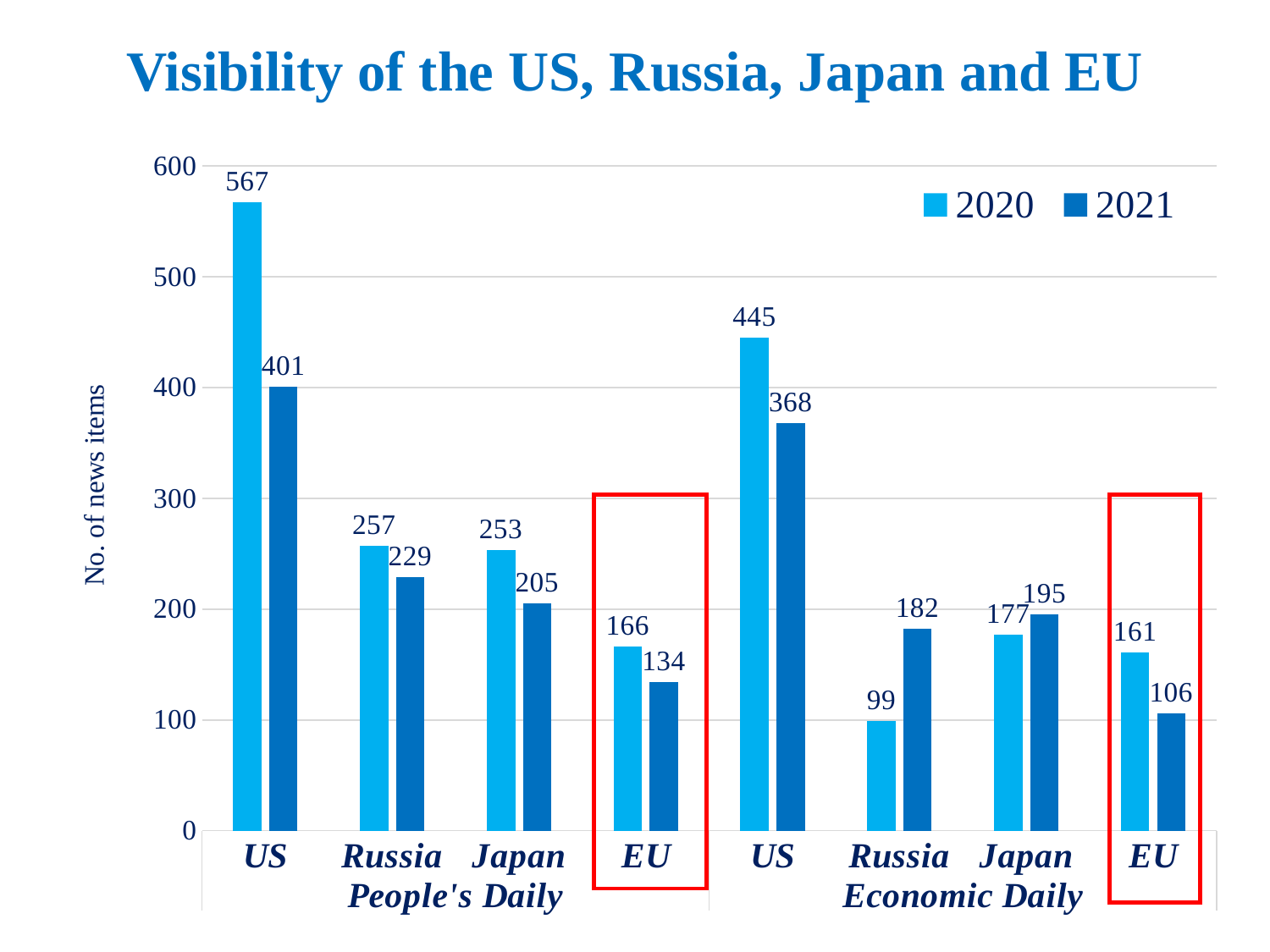
Which category has the lowest 2020 value across both newspapers? Russia (Economic Daily) What is the difference between the 2020 and 2021 values for the US in Economic Daily? 77 What kind of chart is shown on the slide? bar chart What is the label on the vertical axis? No. of news items Is the 2021 value for the US in People's Daily greater or less than 400? greater How many series does the legend list? 2 What is the 2021 value for Russia in Economic Daily? 182 Which category has the highest 2020 value across both newspapers? US (People's Daily) What is the 2020 value for the US in People's Daily? 567 What is the title of the chart? Visibility of the US, Russia, Japan and EU Which is larger for Japan in Economic Daily, the 2020 value or the 2021 value? 2021 What is the 2021 value for the EU in People's Daily? 134